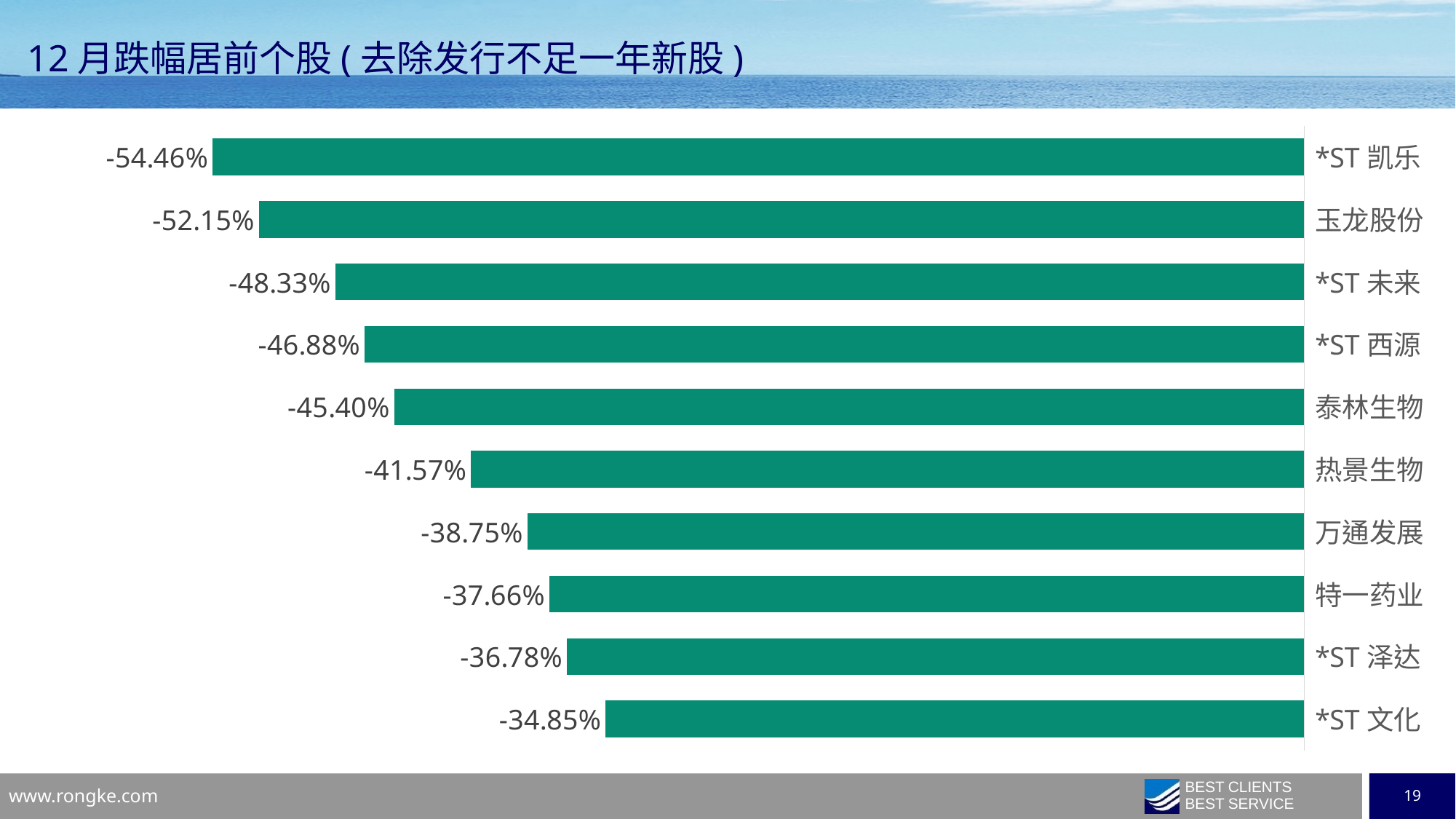
What is the value shown for 万通发展? -38.75% Which stock fell more in December, 热景生物 or 特一药业? 热景生物 What kind of chart is shown on the slide? Bar chart What is the difference in percentage points between the values for *ST 文化 and *ST 凯乐? 19.61 percentage points What is the value shown for 泰林生物? -45.40% Which stock has the smallest decline (the highest value) on the chart? *ST 文化 What is the difference in percentage points between the values for 玉龙股份 and *ST 未来? 3.82 percentage points What is the title of the slide? 12 月跌幅居前个股 ( 去除发行不足一年新股 ) How many stocks are shown on the chart? 10 Which stock has the largest decline (the lowest value) on the chart? *ST 凯乐 What is the value shown for *ST 凯乐? -54.46% What is the value shown for *ST 泽达? -36.78%